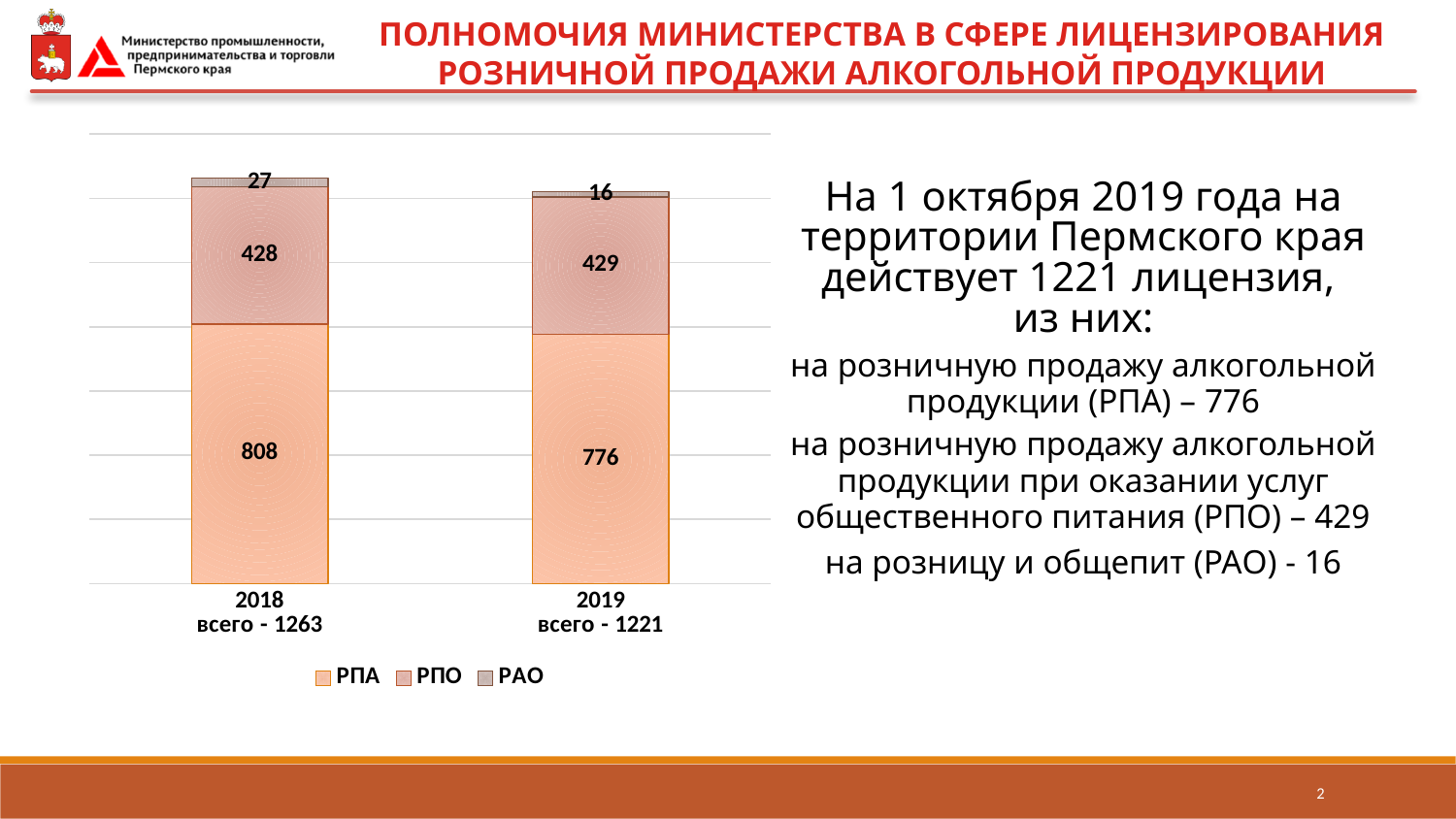
How many series does the legend list? 3 What kind of chart is shown on the slide? Stacked bar chart What is the value of РПА for 2019? 776 What is the value of РПО for 2019? 429 Which series has the highest value in 2019? РПА How many categories (years) are shown on the x axis? 2 What is the difference between the РПА values for 2018 and 2019? 32 Which year has the larger РАО value, 2018 or 2019? 2018 What is the total of the stacked bar for 2019? 1221 What is the value of РАО for 2018? 27 What is the total of the stacked bar for 2018? 1263 What is the value of РПА for 2018? 808